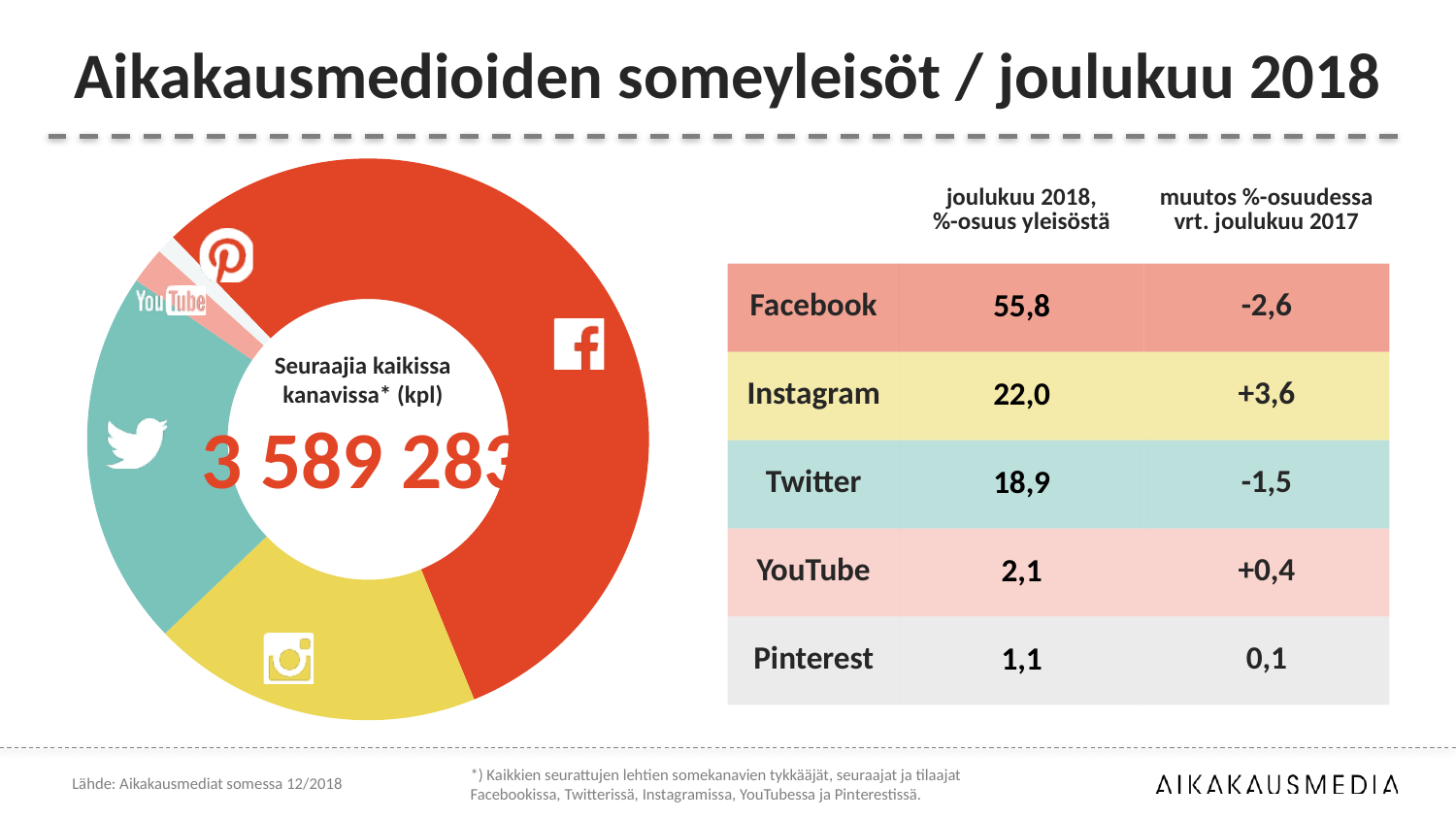
Which channel has the smallest share of the audience in December 2018? Pinterest Which has a larger share of the audience, Twitter or YouTube? Twitter What is the change in Twitter's share compared with December 2017? -1,5 What is the title of the slide? Aikakausmedioiden someyleisöt / joulukuu 2018 Which channel has the largest share of the audience in December 2018? Facebook What kind of chart is shown on the left of the slide? Pie chart (donut) What is Facebook's share of the audience in December 2018? 55,8 How many social media channels are shown as slices in the donut chart? 5 What is the total number of followers across all channels shown in the centre of the donut chart? 3 589 283 What is Instagram's share of the audience in December 2018? 22,0 Which channel had the largest increase in share compared with December 2017? Instagram What is the difference between Facebook's and Instagram's share of the audience in December 2018? 33,8